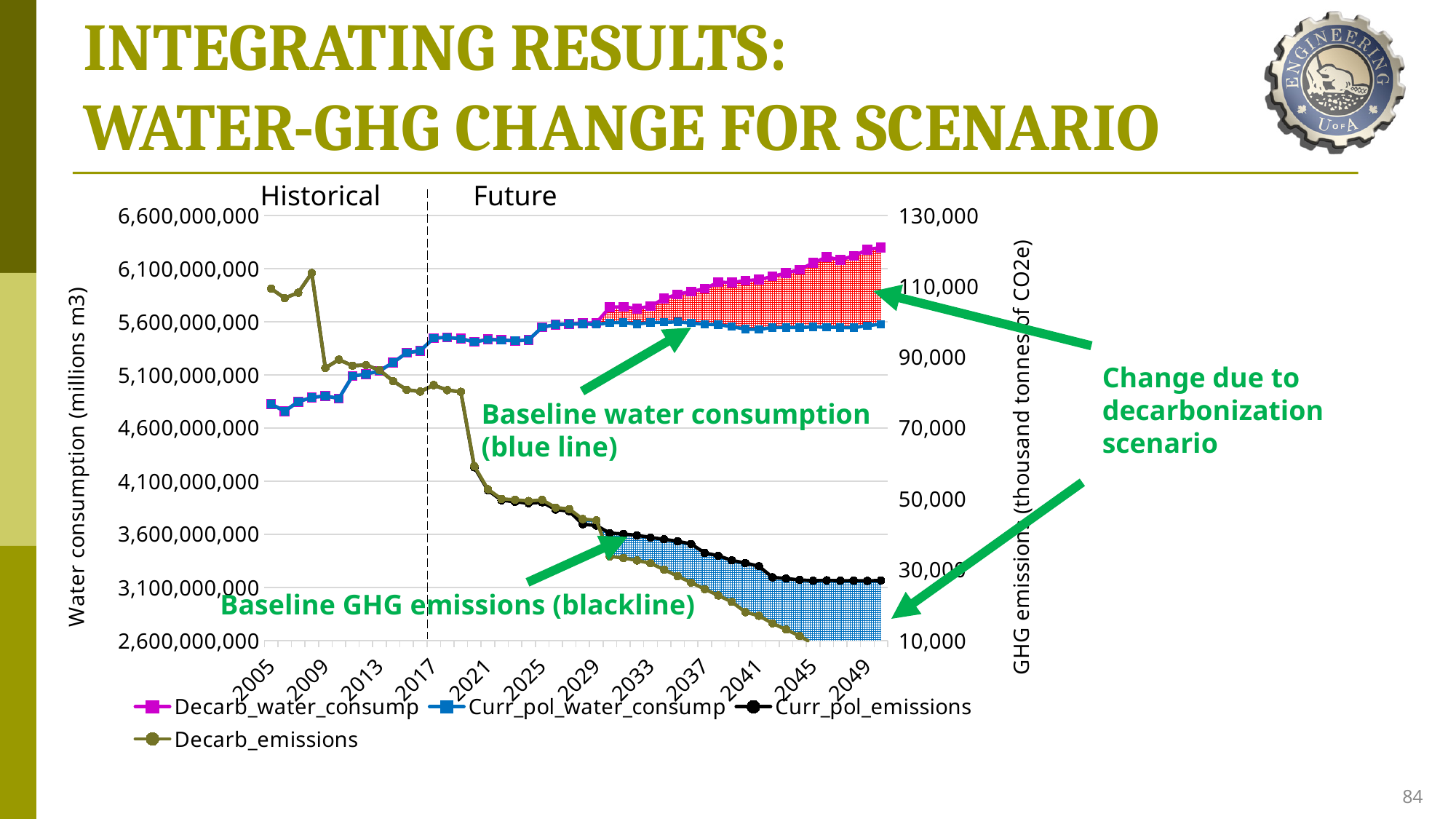
What is the title of the left vertical axis? Water consumption (millions m3) Does the Decarb_water_consump series rise or fall over the Future period? rise In 2049, which series is higher: Decarb_water_consump or Curr_pol_water_consump? Decarb_water_consump Is the value for Curr_pol_emissions in 2049 greater or less than 50,000? less In 2049, which series is lower: Decarb_emissions or Curr_pol_emissions? Decarb_emissions How many series does the legend list? 4 In which year does the Decarb_emissions series reach its highest value? 2008 Is the value for Decarb_water_consump in 2049 greater or less than 6,100,000,000? greater What kind of chart is shown on the slide? line chart Is the value for Decarb_emissions in 2041 greater or less than 30,000? less What is the title of the right vertical axis? GHG emissions (thousand tonnes of CO2e) Does the Decarb_emissions series rise or fall from 2017 to 2049? fall